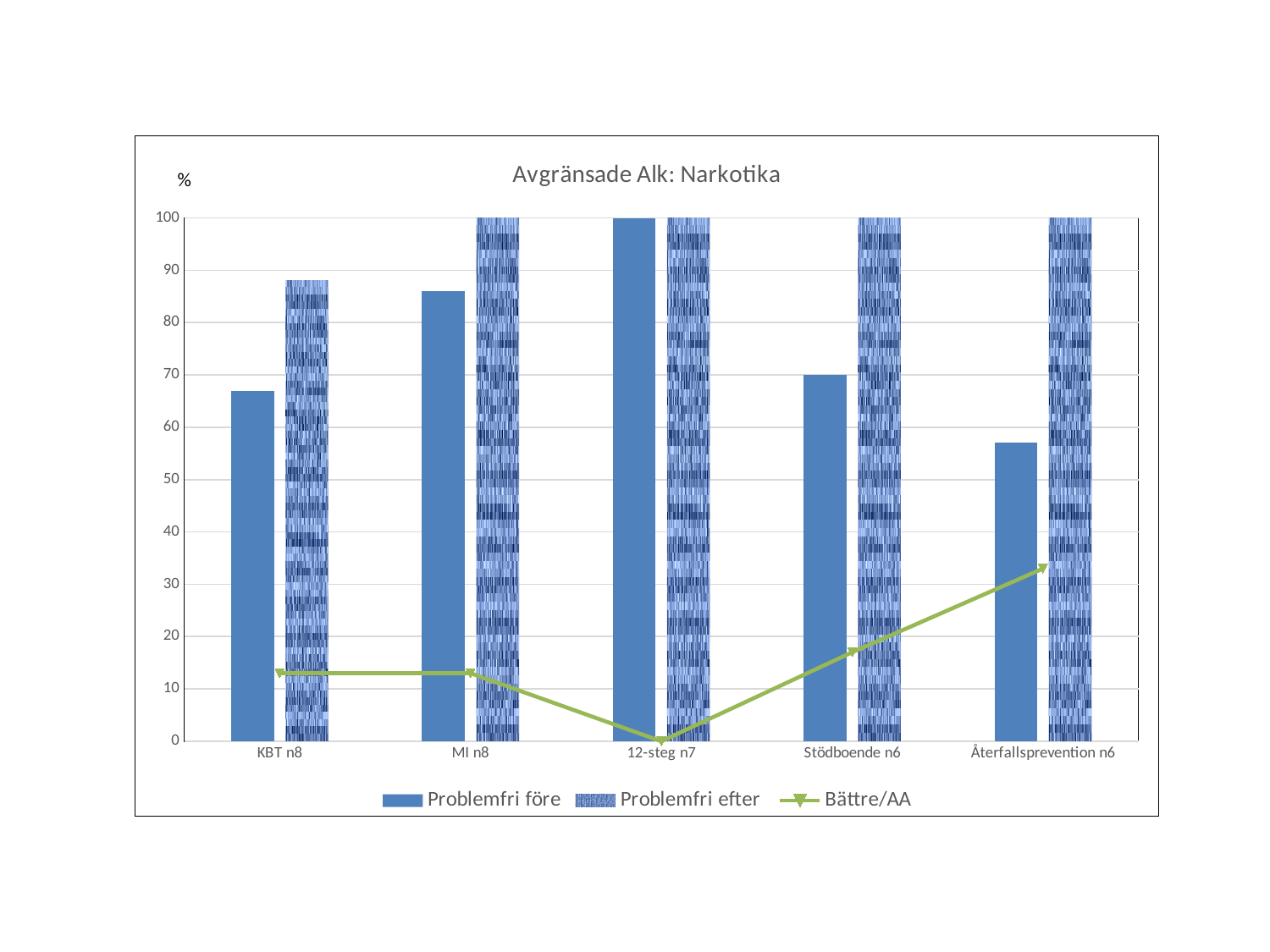
What is the Bättre/AA value for 12-steg n7? 0 Which category has the lowest Problemfri före value? Återfallsprevention n6 Which is larger, the Problemfri före value for MI n8 or for KBT n8? MI n8 What kind of chart is this? Combined bar and line chart Does the Bättre/AA line rise or fall from 12-steg n7 to Återfallsprevention n6? rise What is the Problemfri efter value for 12-steg n7? 100 How many series does the legend list? 3 How many categories are shown on the x axis? 5 What is the Problemfri före value for Stödboende n6? 70 Is the Problemfri efter value for KBT n8 greater or less than 80? greater What is the title of the chart? Avgränsade Alk: Narkotika Which category has the highest Problemfri före value? 12-steg n7